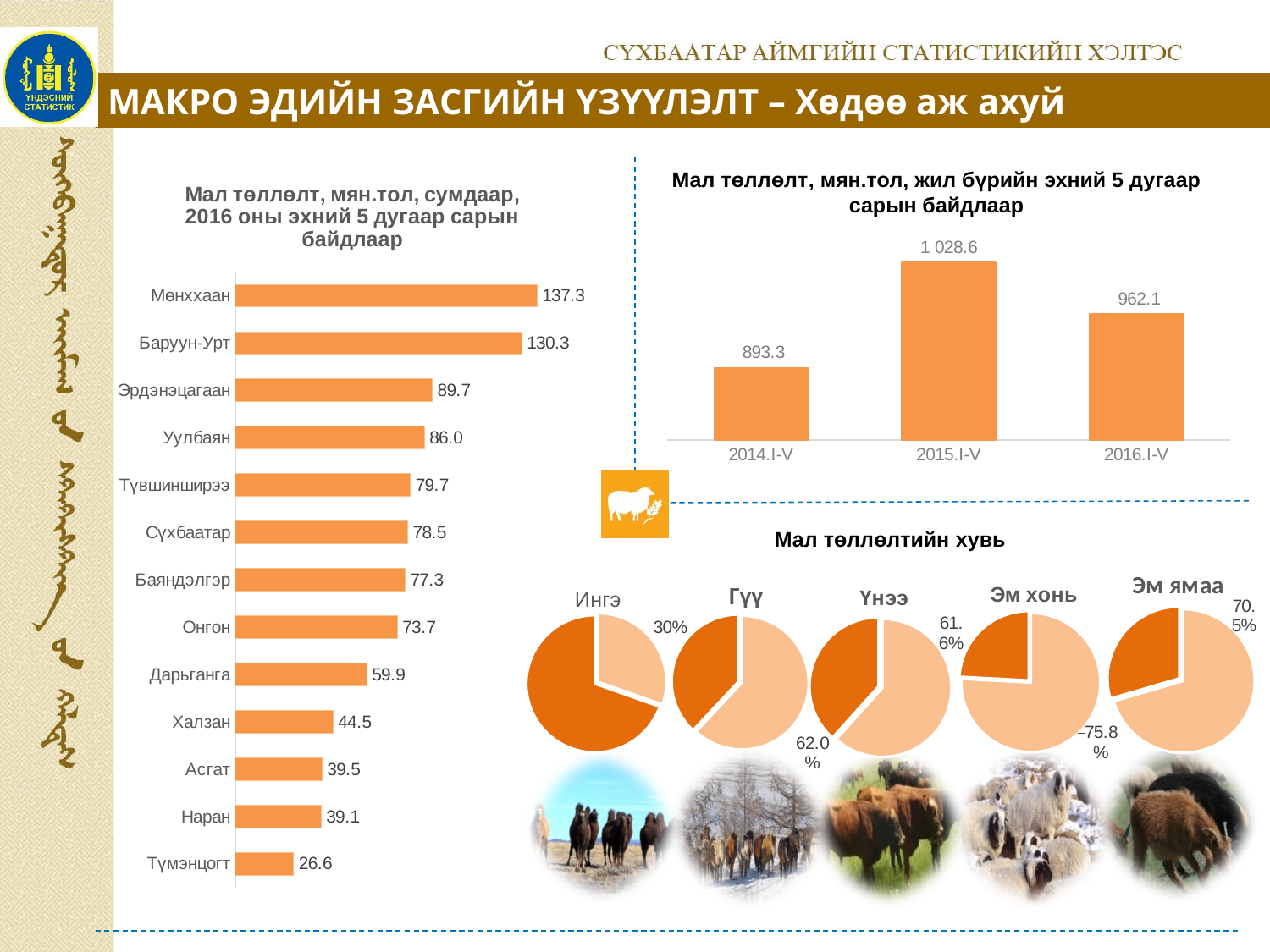
In the left chart 'Мал төллөлт, мян.тол, сумдаар', what is the difference between Мөнххаан and Баруун-Урт? 7.0 In the top-right chart 'Мал төллөлт, мян.тол, жил бүрийн эхний 5 дугаар сарын байдлаар', which year has the lowest value? 2014.I-V How many categories are shown in the left chart 'Мал төллөлт, мян.тол, сумдаар'? 13 What type of chart is the left chart 'Мал төллөлт, мян.тол, сумдаар'? Bar chart In the left chart 'Мал төллөлт, мян.тол, сумдаар', which is larger, Уулбаян or Түвшинширээ? Уулбаян In the top-right chart 'Мал төллөлт, мян.тол, жил бүрийн эхний 5 дугаар сарын байдлаар', what is the difference between 2015.I-V and 2016.I-V? 66.5 In the left chart 'Мал төллөлт, мян.тол, сумдаар', which category has the highest value? Мөнххаан In the top-right chart 'Мал төллөлт, мян.тол, жил бүрийн эхний 5 дугаар сарын байдлаар', what is the value for 2015.I-V? 1 028.6 In the left chart 'Мал төллөлт, мян.тол, сумдаар', what is the value for Дарьганга? 59.9 In the left chart 'Мал төллөлт, мян.тол, сумдаар, 2016 оны эхний 5 дугаар сарын байдлаар', what is the value for Мөнххаан? 137.3 In the left chart 'Мал төллөлт, мян.тол, сумдаар', which category has the lowest value? Түмэнцогт How many pie charts are shown under the title 'Мал төллөлтийн хувь'? 5